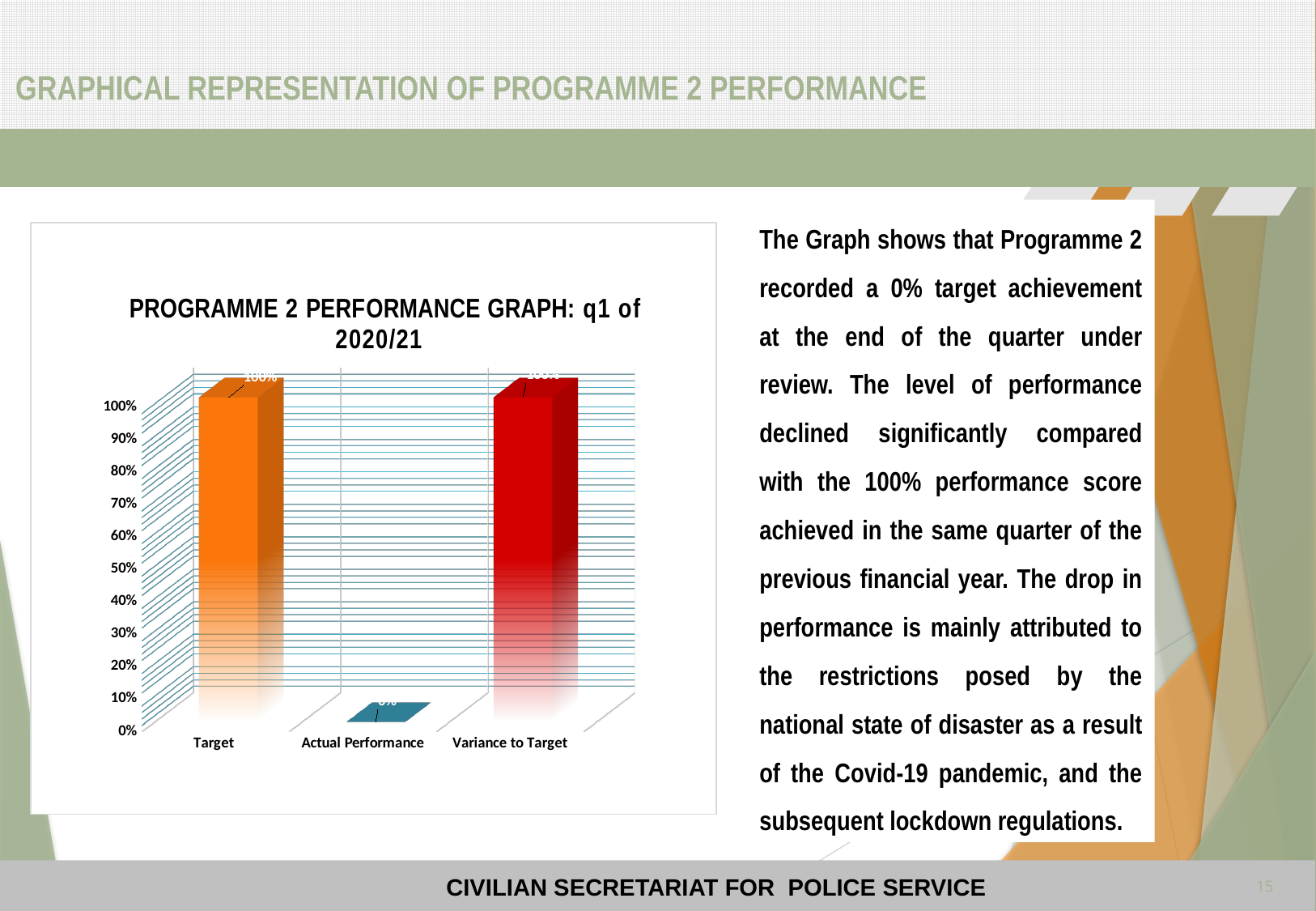
How many categories are shown on the x axis of the chart? 3 What is the value for Target in the chart? 100% Which is larger, the value for Target or the value for Actual Performance? Target What type of chart is shown on the slide? bar chart Which category has the lowest value in the chart? Actual Performance What is the difference between the Target value and the Actual Performance value? 100% What is the highest value shown on the y axis of the chart? 100% What is the value for Actual Performance in the chart? 0% Is the value for Actual Performance greater or less than 10%? less Which category is labelled in the middle of the x axis? Actual Performance Is the value for Variance to Target greater or less than 50%? greater What is the title of the chart? PROGRAMME 2 PERFORMANCE GRAPH: q1 of 2020/21